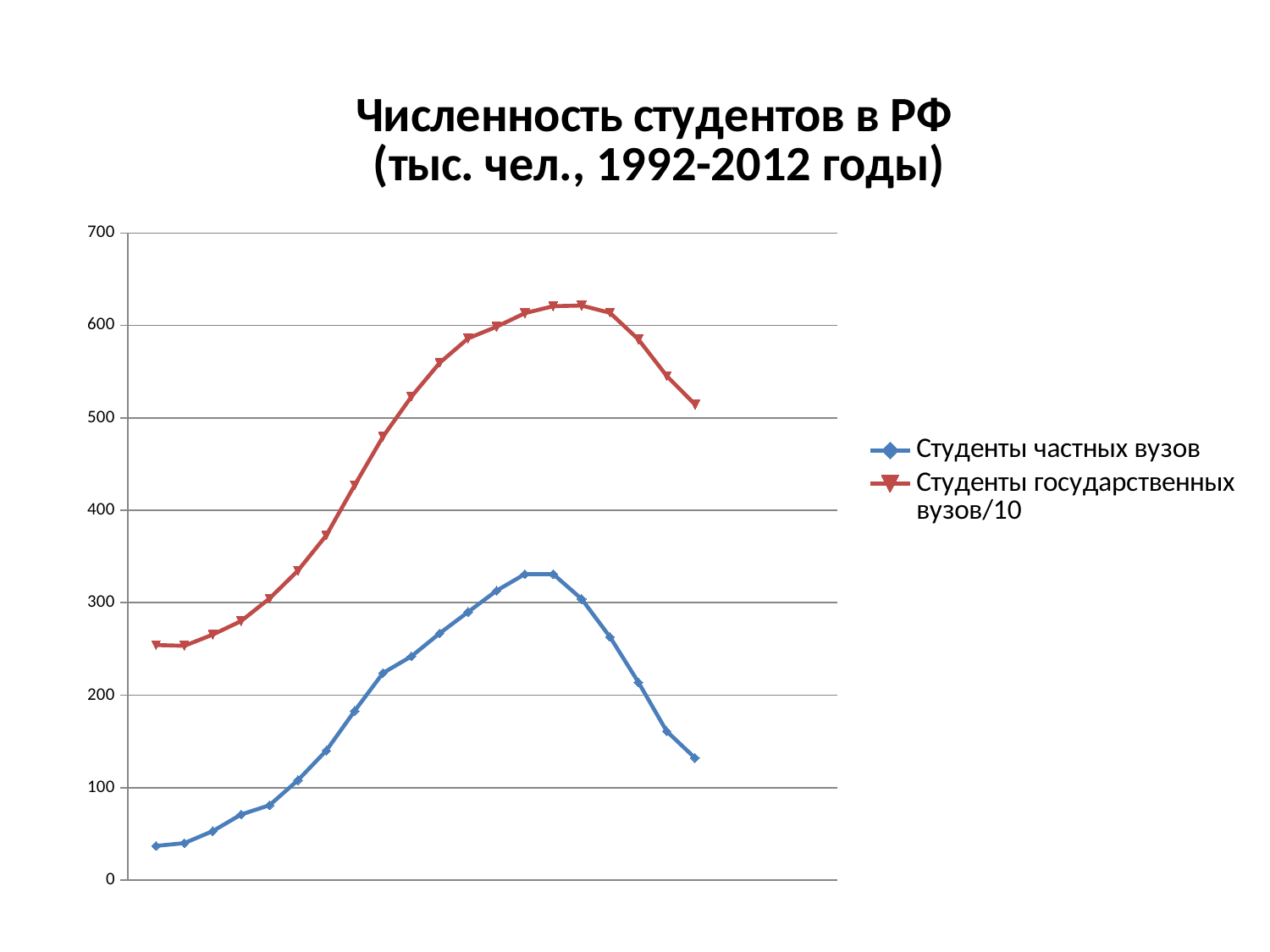
Which series reaches the higher peak value, Студенты частных вузов or Студенты государственных вузов/10? Студенты государственных вузов/10 Is the last (rightmost) value of the Студенты государственных вузов/10 series greater or less than 500? greater Is the peak value of the Студенты частных вузов series greater or less than 300? greater What kind of chart is shown on the slide? line chart Is the first (leftmost) value of the Студенты государственных вузов/10 series greater or less than 300? less What is the title of the chart? Численность студентов в РФ (тыс. чел., 1992-2012 годы) Which series lies above the other across the whole chart? Студенты государственных вузов/10 How many series does the legend list? 2 Which series is drawn in red with triangle markers? Студенты государственных вузов/10 How does the Студенты частных вузов series change along the x axis overall? rises to a peak, then falls